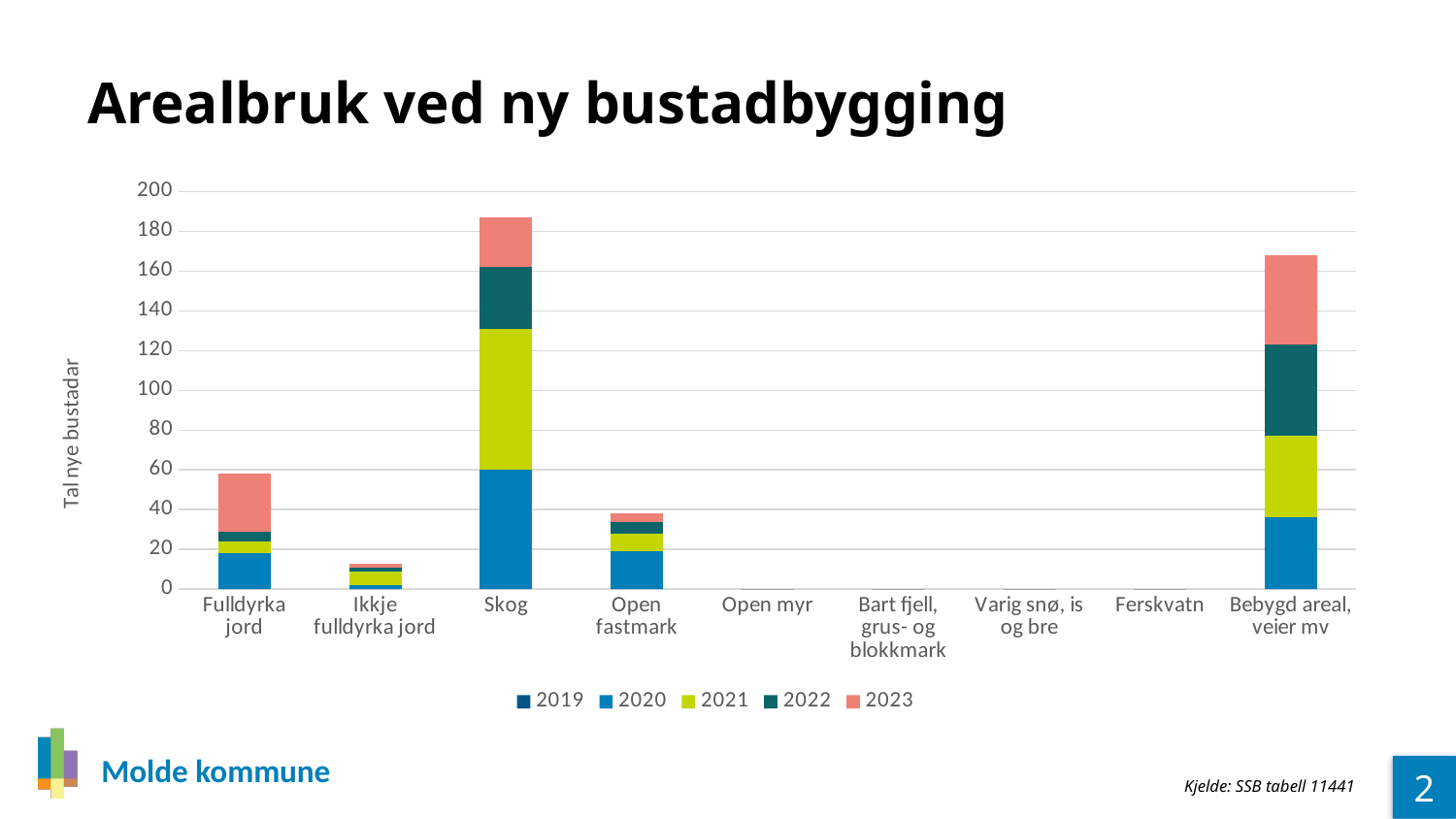
Which has the taller stacked bar, Skog or Bebygd areal, veier mv? Skog Is the total stacked value for Skog greater or less than 160? greater What kind of chart is shown on the slide? Stacked bar chart How many categories are shown on the x axis of the chart? 9 Which category has the highest total stacked bar? Skog What is the label on the vertical axis of the chart? Tal nye bustadar Is the total stacked value for Open fastmark greater or less than 60? less Which has the taller stacked bar, Fulldyrka jord or Open fastmark? Fulldyrka jord Is the total stacked value for Bebygd areal, veier mv greater or less than 140? greater Which has the taller stacked bar, Fulldyrka jord or Ikkje fulldyrka jord? Fulldyrka jord How many series does the legend list? 5